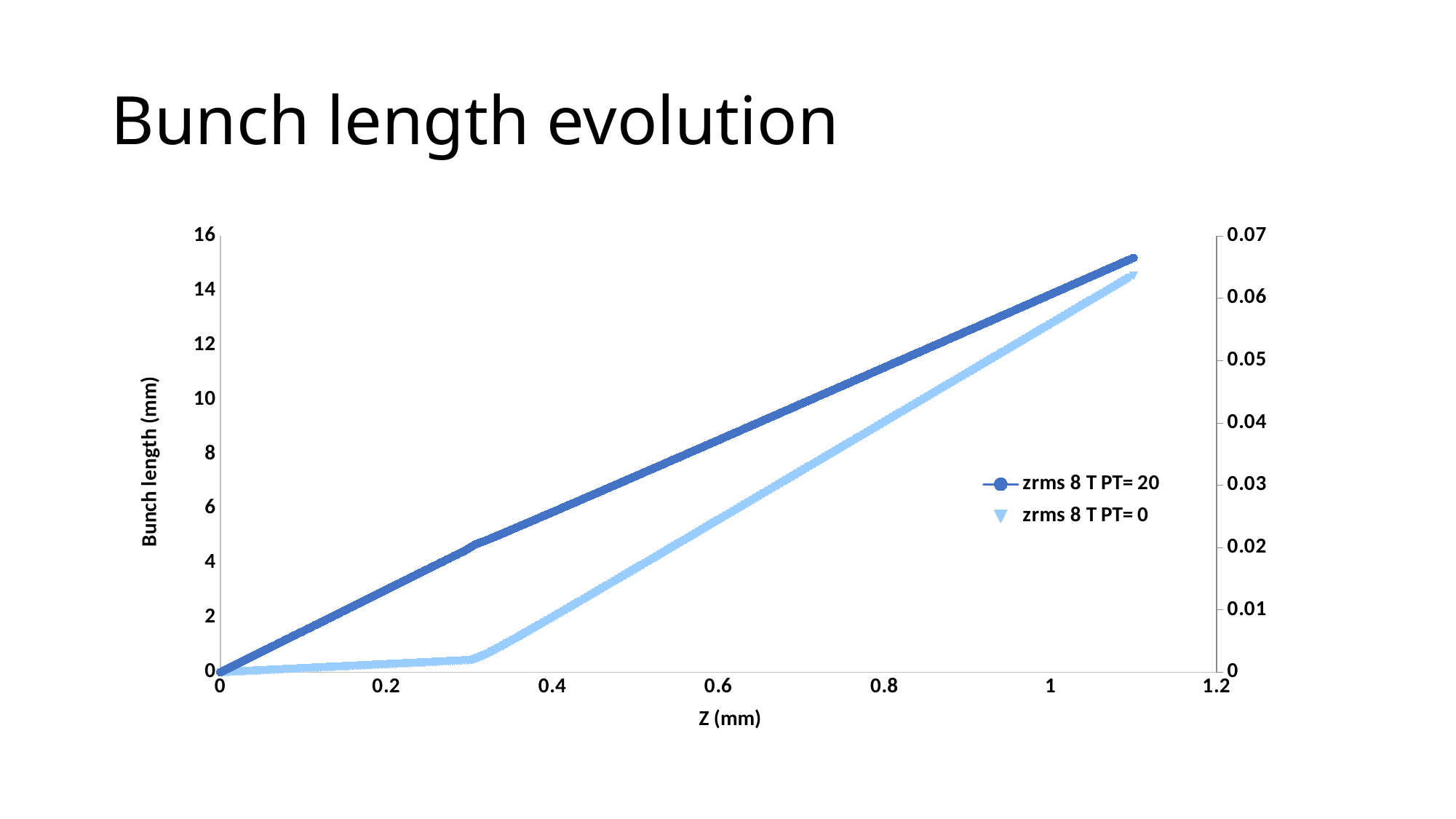
Do the values of the zrms 8 T PT= 20 series rise or fall as Z increases? rise Do the values of the zrms 8 T PT= 0 series rise or fall as Z increases? rise What is the label of the x axis? Z (mm) What is the title of the slide containing the chart? Bunch length evolution At Z = 0.6, which series is plotted higher on the chart, zrms 8 T PT= 20 or zrms 8 T PT= 0? zrms 8 T PT= 20 What is the maximum value shown on the right y axis? 0.07 What is the maximum value shown on the left y axis? 16 What kind of chart is shown on the slide? line chart What is the label of the left y axis? Bunch length (mm) What are the two series named in the legend? zrms 8 T PT= 20 and zrms 8 T PT= 0 How many series does the chart legend list? 2 Which series is plotted higher at the right-hand end of the chart (around Z = 1.1)? zrms 8 T PT= 20